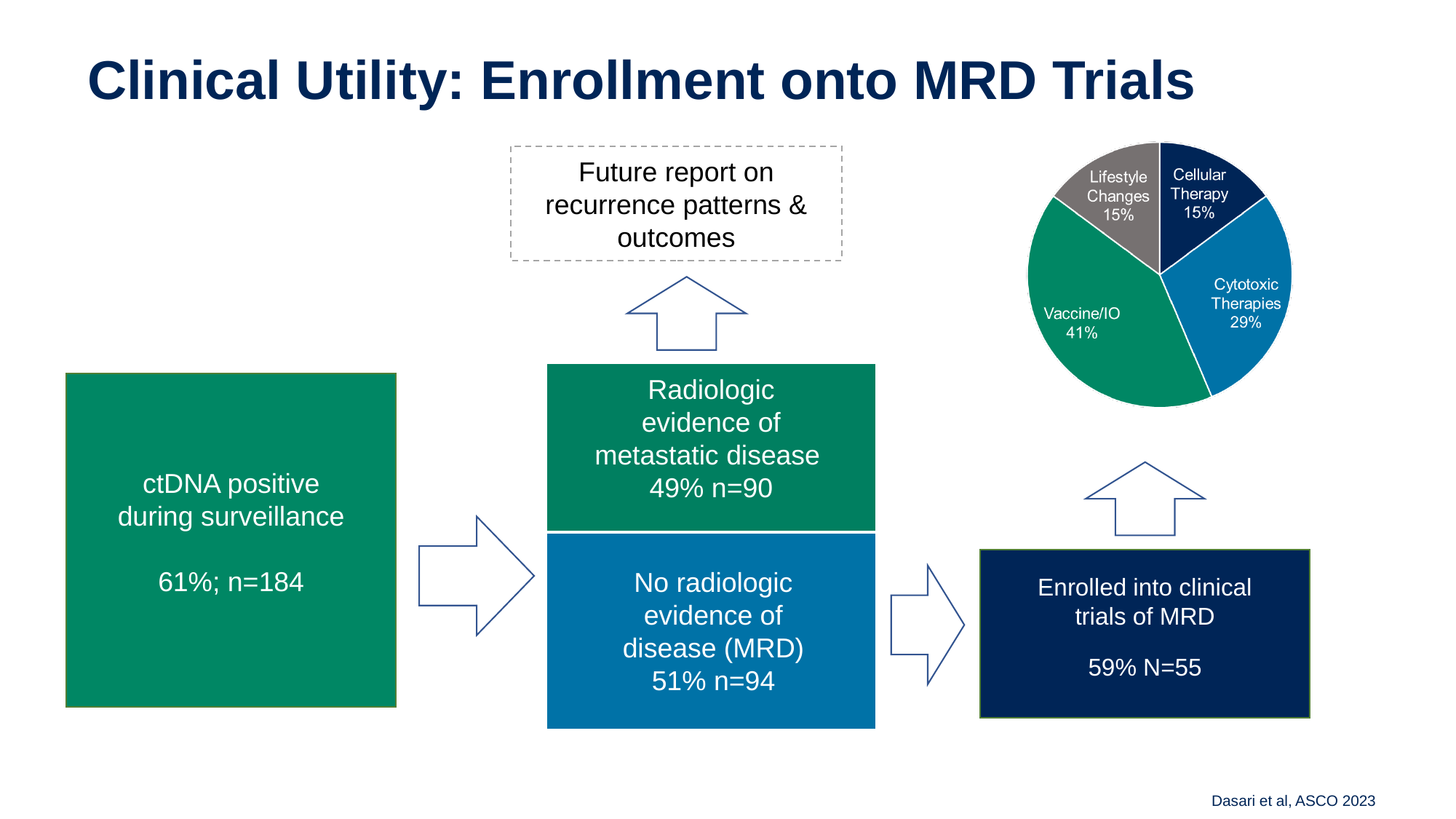
In the pie chart, what share is labelled for Vaccine/IO? 41% Which slice of the pie chart is the largest? Vaccine/IO What kind of chart is shown in the top right of the slide? pie chart In the pie chart, what is the difference between the Vaccine/IO share and the Cytotoxic Therapies share? 12% In the pie chart, what colour is the Vaccine/IO slice? green In the pie chart, what share is labelled for Cytotoxic Therapies? 29% In the pie chart, what share is labelled for Lifestyle Changes? 15% In the pie chart, what colour is the Lifestyle Changes slice? grey In the pie chart, what share is labelled for Cellular Therapy? 15% How many slices does the pie chart have? 4 In the pie chart, what is the combined share of Lifestyle Changes and Cellular Therapy? 30% In the pie chart, which is larger: Cytotoxic Therapies or Cellular Therapy? Cytotoxic Therapies